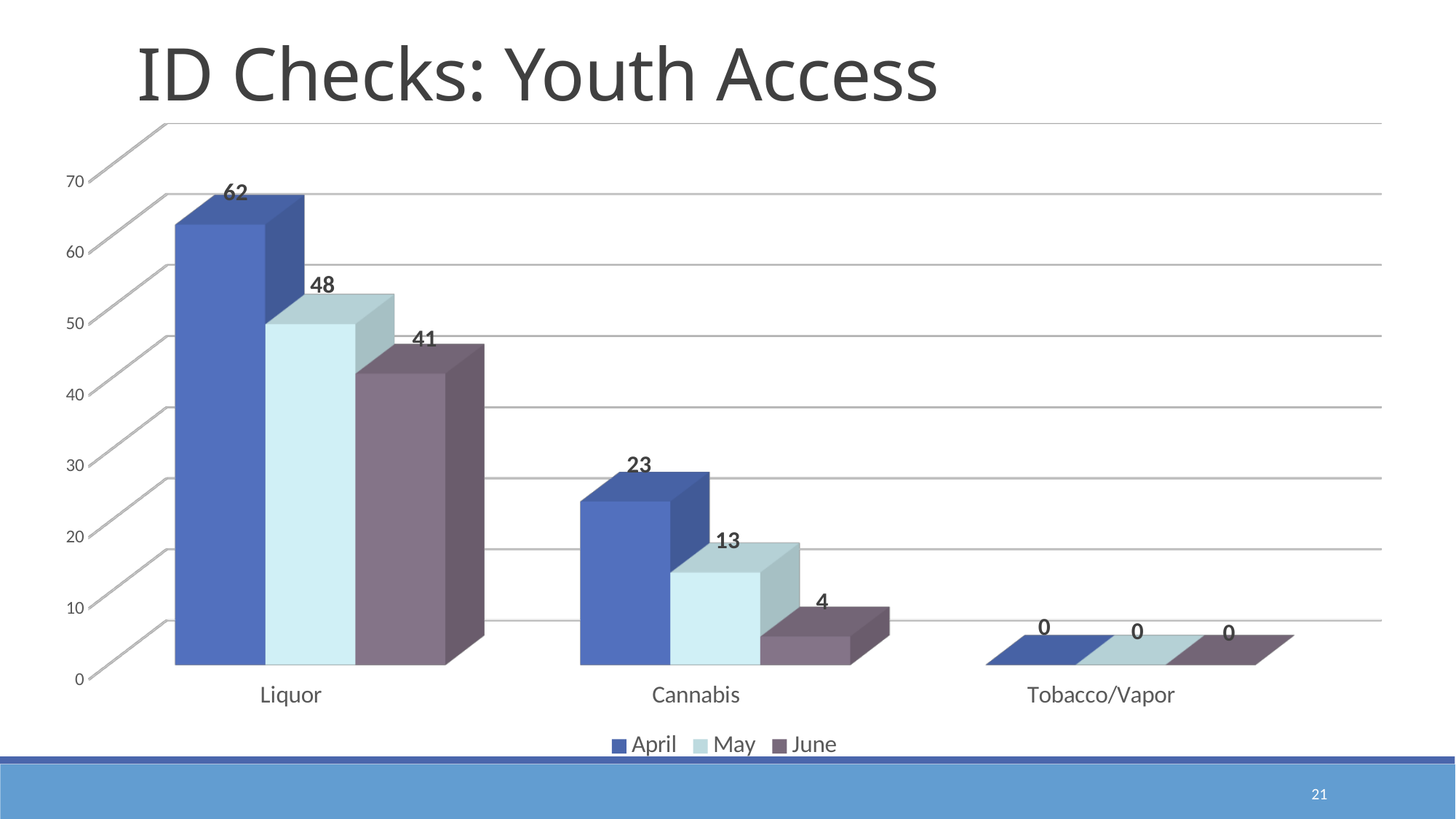
What is the value for Liquor in April? 62 How many categories are shown on the x axis? 3 Which category has the lowest value in June? Tobacco/Vapor What is the value for Cannabis in June? 4 What is the value for Cannabis in May? 13 What is the title of the slide? ID Checks: Youth Access Which category has the highest value in April? Liquor What is the value for Tobacco/Vapor in April? 0 How many series does the legend list? 3 What is the difference between the April and May values for Liquor? 14 Which is larger, the June value for Liquor or the April value for Cannabis? June value for Liquor What kind of chart is shown on the slide? Bar chart